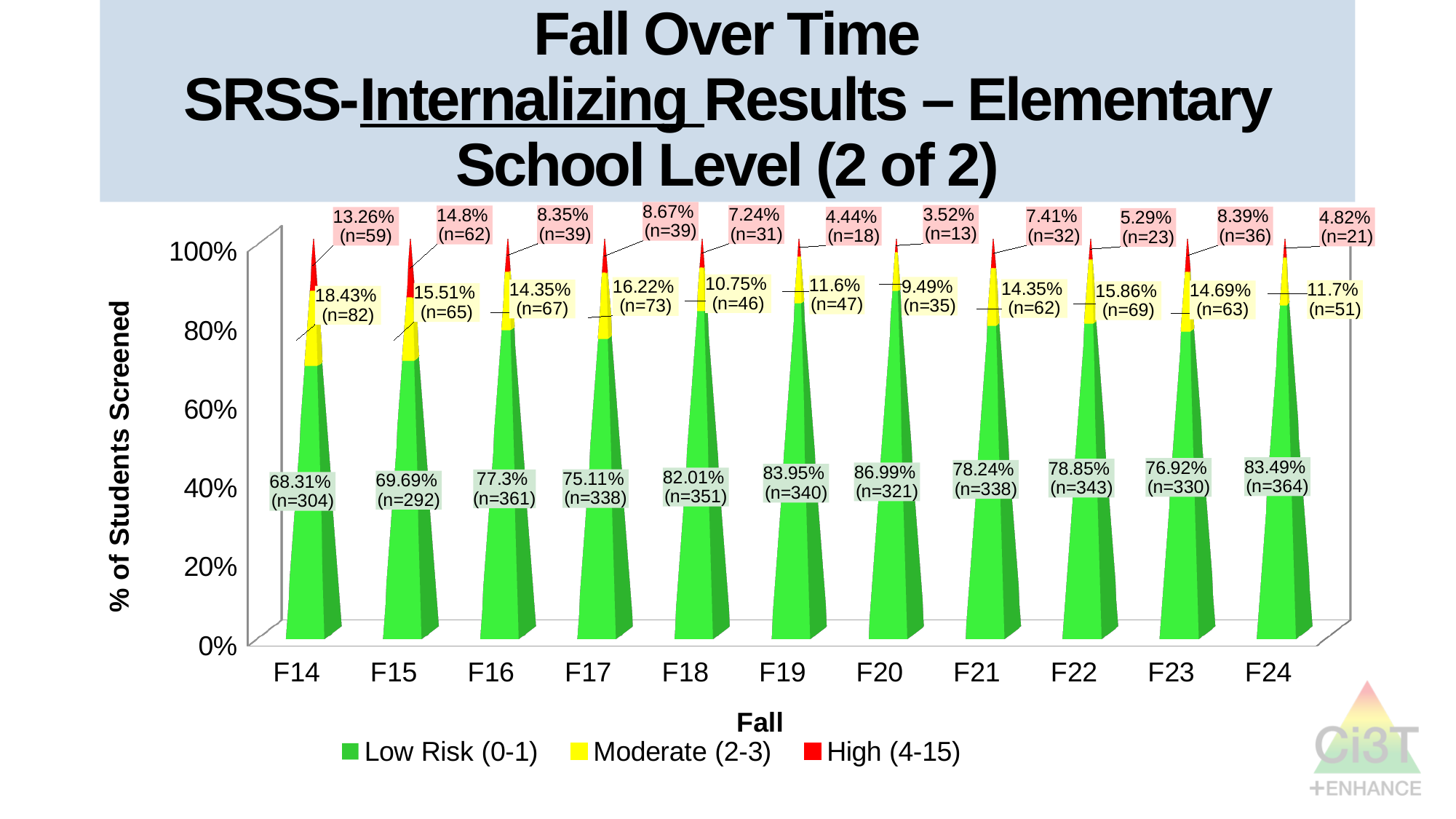
How many series does the legend list? 3 How many students were in the Moderate (2-3) category in F17? n=73 How many fall time points are shown on the x axis? 11 Which fall has the lowest High (4-15) percentage? F20 Which fall has the highest Low Risk (0-1) percentage? F20 What is the difference in Low Risk (0-1) percentage between F20 and F14? 18.68 percentage points Which is larger, the Moderate (2-3) percentage in F14 or in F24? F14 Which fall has the highest High (4-15) percentage? F15 What percentage of students were High (4-15) in F14? 13.26% What kind of chart is shown on the slide? Stacked bar chart What percentage of students were Low Risk (0-1) in F20? 86.99% Which fall has the lowest Low Risk (0-1) percentage? F14